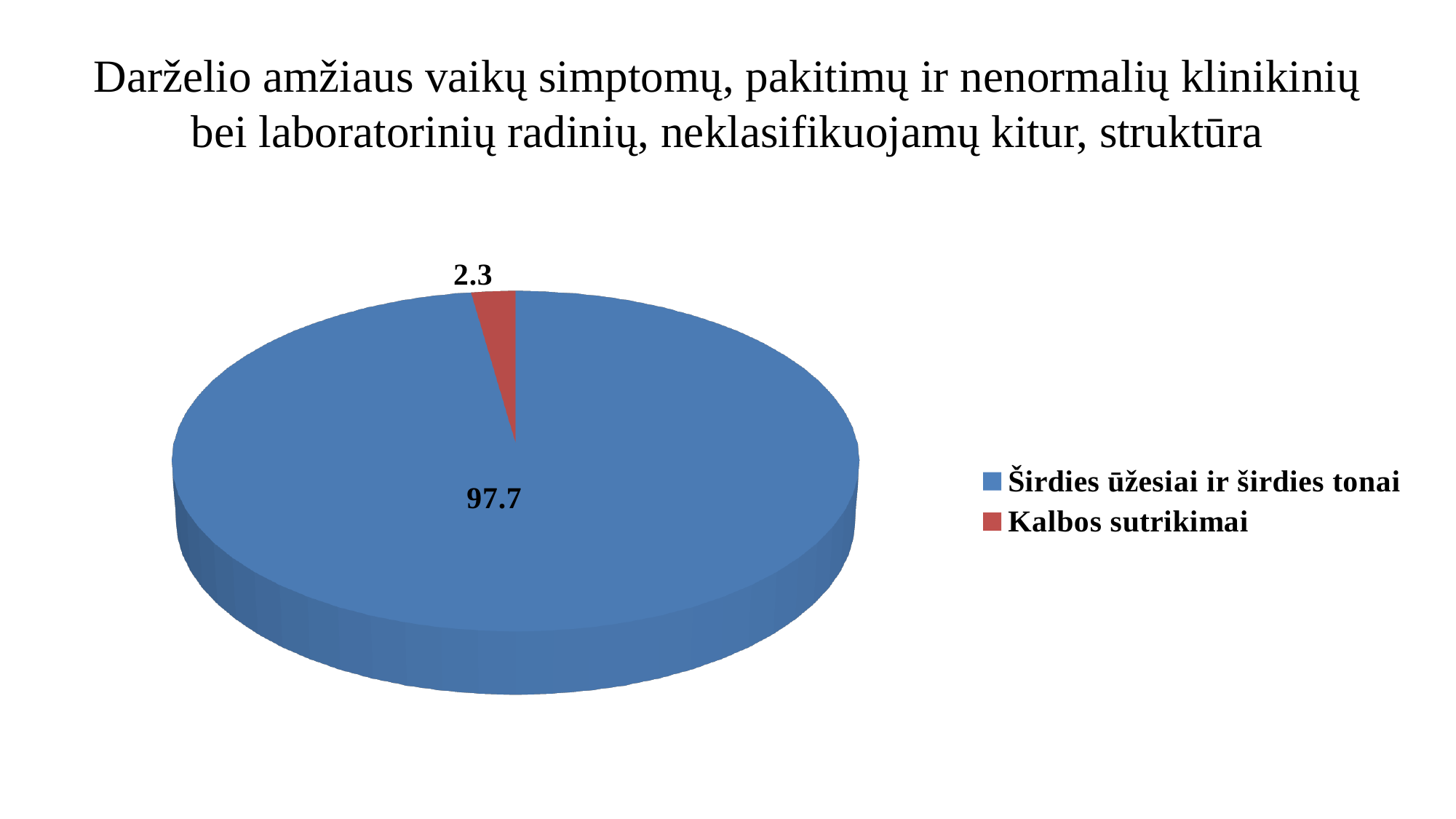
Which category has the largest slice? Širdies ūžesiai ir širdies tonai What kind of chart is shown on the slide? Pie chart How many slices does the pie chart have? 2 What is the difference between the values for Širdies ūžesiai ir širdies tonai and Kalbos sutrikimai? 95.4 How many entries does the legend list? 2 What is the total of the two slice values? 100 Which category has the smallest slice? Kalbos sutrikimai What colour is the slice for Širdies ūžesiai ir širdies tonai? Blue What is the value for Širdies ūžesiai ir širdies tonai? 97.7 Which is larger, the value for Širdies ūžesiai ir širdies tonai or the value for Kalbos sutrikimai? Širdies ūžesiai ir širdies tonai What colour is the slice for Kalbos sutrikimai? Red What is the value for Kalbos sutrikimai? 2.3